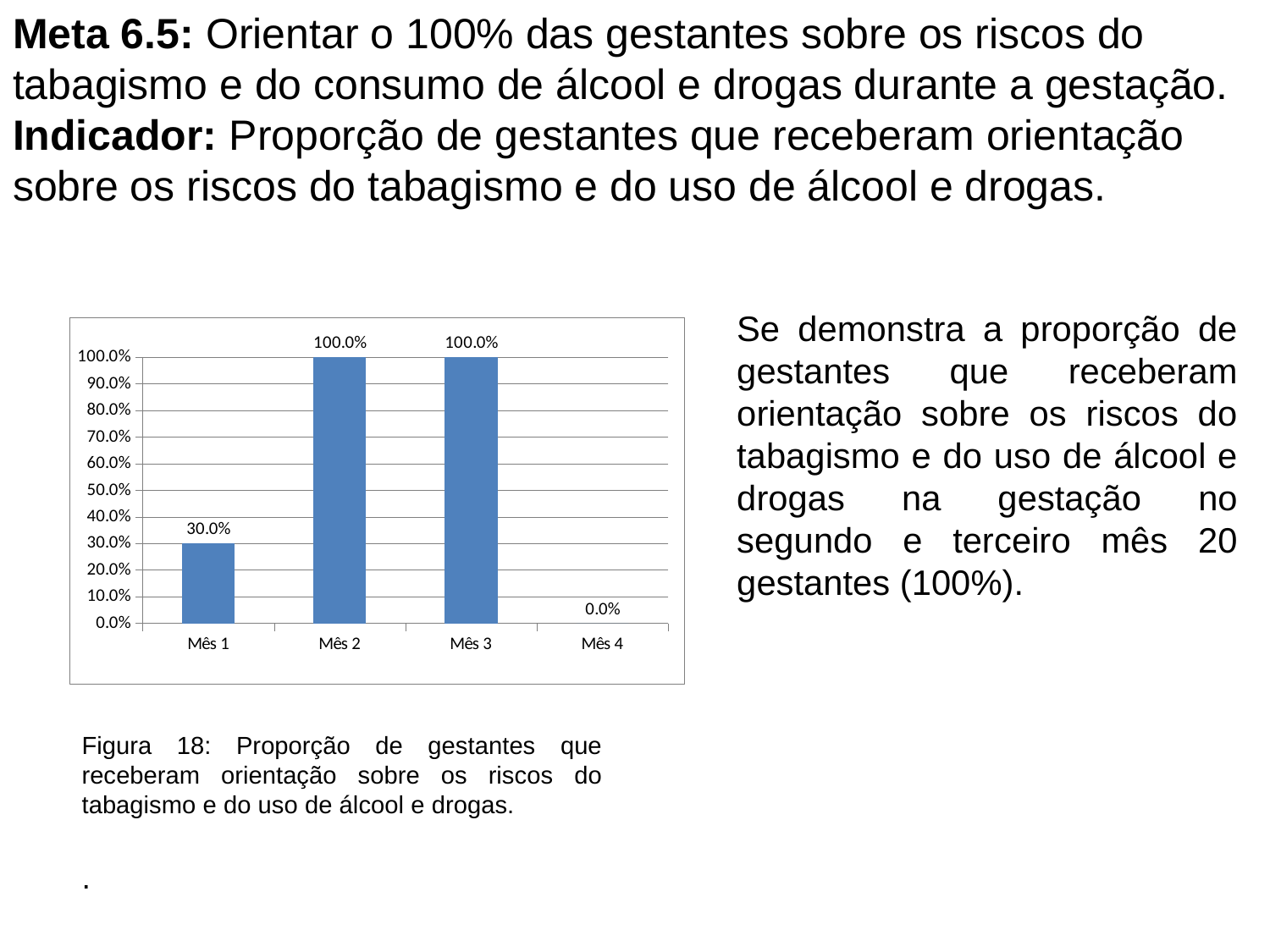
What kind of chart is shown on the slide? bar chart Does the value rise or fall from Mês 1 to Mês 2? rise What is the value for Mês 4? 0.0% What is the value for Mês 2? 100.0% What is the value for Mês 1? 30.0% Does the value rise or fall from Mês 3 to Mês 4? fall Which is larger, the value for Mês 1 or the value for Mês 3? Mês 3 Which category has the lowest value? Mês 4 What is the highest value shown on the y axis? 100.0% Is the value for Mês 1 greater or less than 50.0%? less How many categories are shown on the x axis? 4 What is the difference between the values for Mês 2 and Mês 1? 70.0%